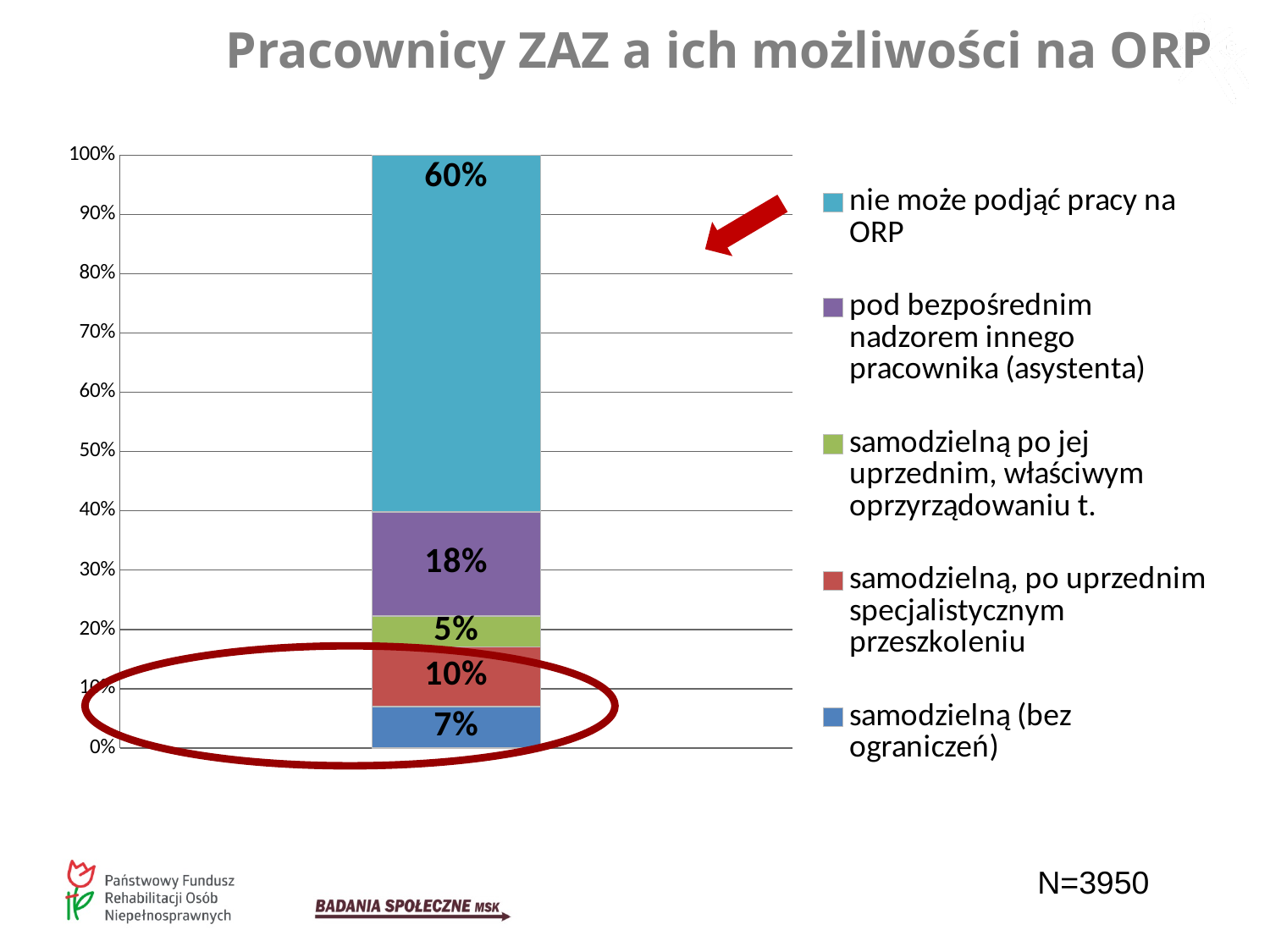
What colour is the segment for "nie może podjąć pracy na ORP"? Light blue (teal) Which is larger: the "samodzielną, po uprzednim specjalistycznym przeszkoleniu" segment or the "samodzielną (bez ograniczeń)" segment? samodzielną, po uprzednim specjalistycznym przeszkoleniu What percentage of ZAZ employees cannot take up work on the open labour market ("nie może podjąć pracy na ORP")? 60% Which legend category has the largest share of the stacked bar? nie może podjąć pracy na ORP How many series does the legend list? 5 What is the value for the segment "samodzielną (bez ograniczeń)"? 7% What is the difference between the "nie może podjąć pracy na ORP" segment and the "pod bezpośrednim nadzorem innego pracownika (asystenta)" segment? 42% What is the value for the segment "pod bezpośrednim nadzorem innego pracownika (asystenta)"? 18% What is the value for the segment "samodzielną, po uprzednim specjalistycznym przeszkoleniu"? 10% What kind of chart is shown on the slide? Stacked bar chart What is the total of all segments in the stacked bar? 100% Which legend category has the smallest share of the stacked bar? samodzielną po jej uprzednim, właściwym oprzyrządowaniu t.